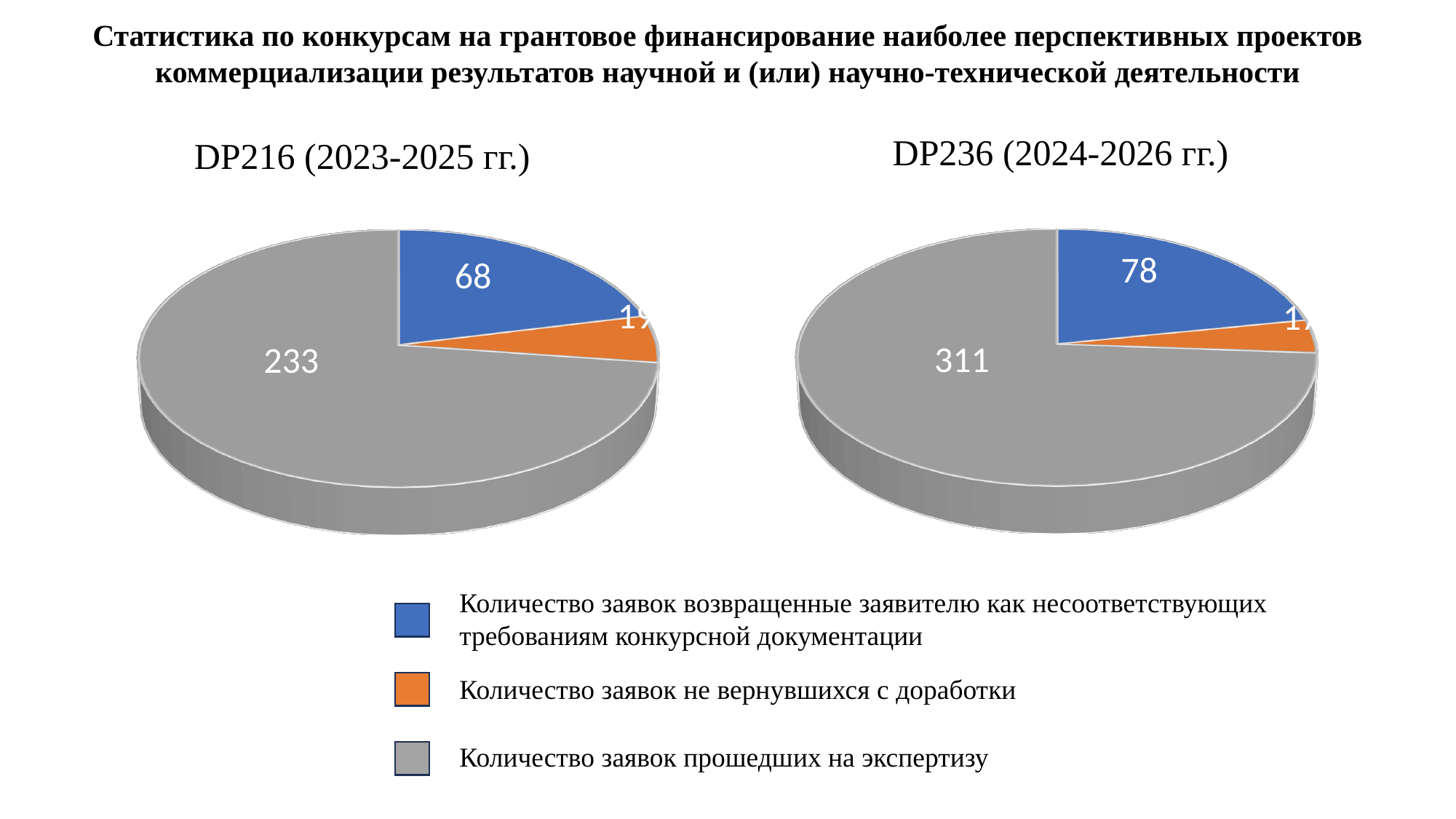
Which is larger: the value for 'Количество заявок прошедших на экспертизу' in the DP216 (2023-2025 гг.) chart or in the DP236 (2024-2026 гг.) chart? DP236 (2024-2026 гг.) What colour is the slice for 'Количество заявок не вернувшихся с доработки' in the charts? Orange What kind of chart is the DP236 (2024-2026 гг.) chart? Pie chart In the DP236 (2024-2026 гг.) chart, what is the difference between the value for 'Количество заявок прошедших на экспертизу' and the value for 'Количество заявок возвращенные заявителю как несоответствующих требованиям конкурсной документации'? 233 In the DP216 (2023-2025 гг.) chart, what is the value for 'Количество заявок возвращенные заявителю как несоответствующих требованиям конкурсной документации'? 68 In the DP216 (2023-2025 гг.) chart, what is the value for 'Количество заявок прошедших на экспертизу'? 233 How many slices does the DP216 (2023-2025 гг.) chart have? 3 In the DP236 (2024-2026 гг.) chart, what is the value for 'Количество заявок возвращенные заявителю как несоответствующих требованиям конкурсной документации'? 78 In the DP236 (2024-2026 гг.) chart, which category has the smallest slice? Количество заявок не вернувшихся с доработки In the DP236 (2024-2026 гг.) chart, what is the value for 'Количество заявок прошедших на экспертизу'? 311 In the DP216 (2023-2025 гг.) chart, which category has the largest slice? Количество заявок прошедших на экспертизу In the DP216 (2023-2025 гг.) chart, what is the difference between the value for 'Количество заявок прошедших на экспертизу' and the value for 'Количество заявок возвращенные заявителю как несоответствующих требованиям конкурсной документации'? 165